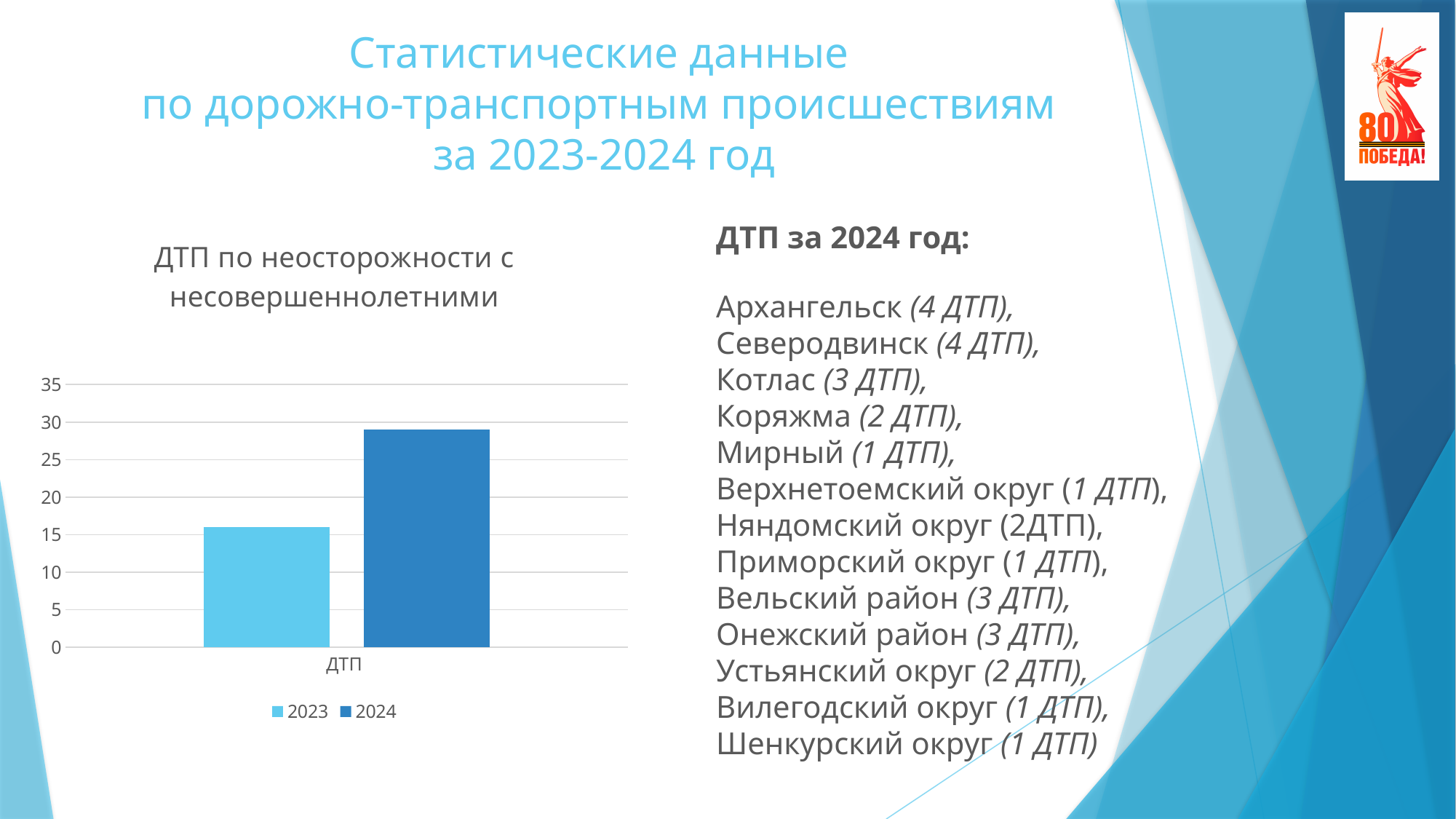
How many categories are shown on the x axis of the chart? 1 What kind of chart is shown on the slide? bar chart Which series are listed in the chart's legend? 2023 and 2024 What is the label of the category on the x axis of the chart? ДТП Is the value for 2024 greater or less than 25? greater Is the value for 2023 greater or less than 20? less Which series has the higher bar in the chart, 2023 or 2024? 2024 Is the value for 2024 greater or less than 35? less Which series has the lowest bar in the chart? 2023 What is the title of the chart on the slide? ДТП по неосторожности с несовершеннолетними How many series does the chart's legend list? 2